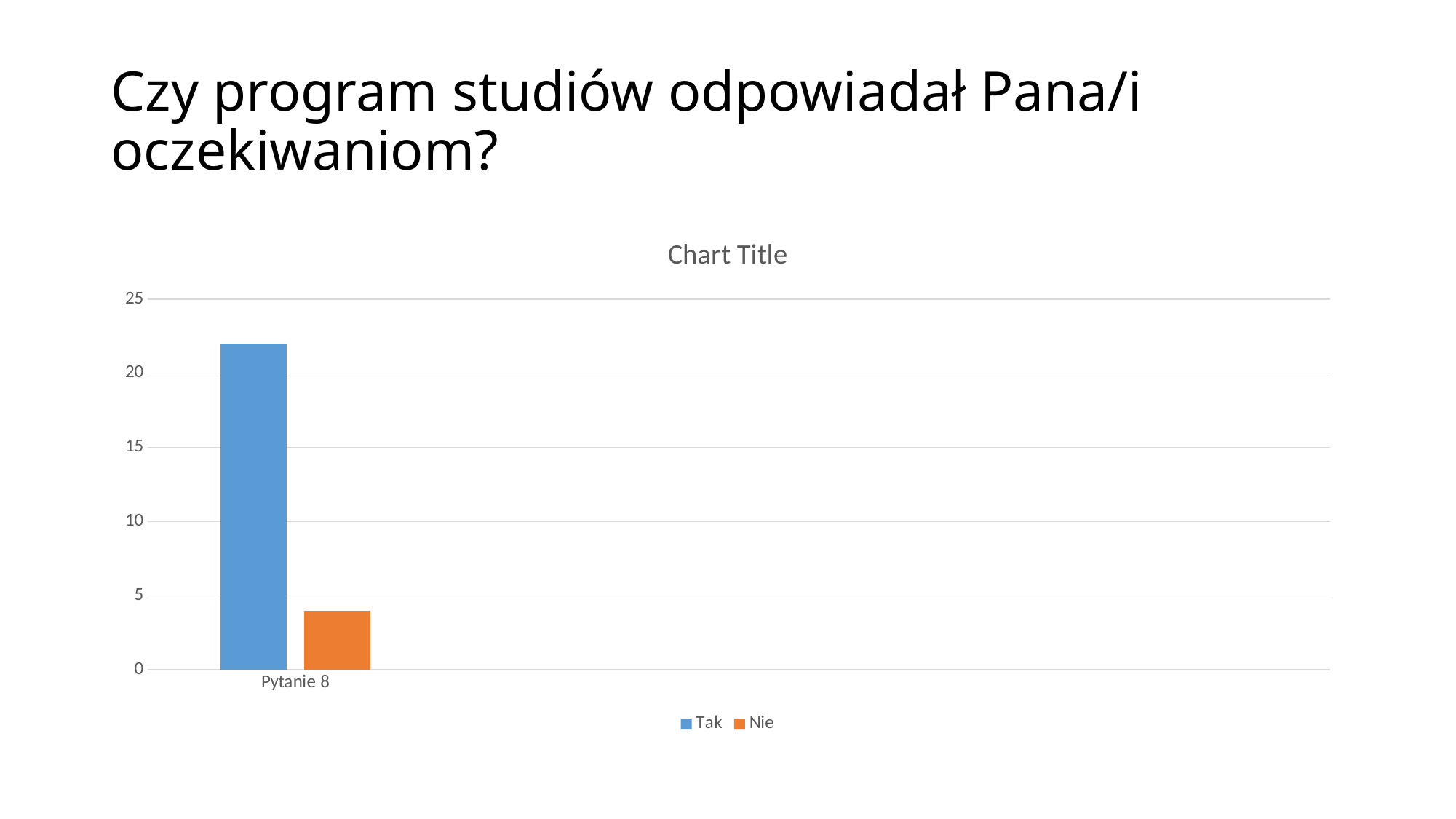
Which series has the higher value for Pytanie 8, Tak or Nie? Tak Which series has the lowest value for Pytanie 8? Nie How many categories are shown on the x axis? 1 Is the value for Tak greater or less than 25? less What kind of chart is shown on the slide? bar chart What colour is the bar for the Nie series? orange Is the value for Nie greater or less than 10? less Is the value for Tak greater or less than 20? greater What is the title shown above the chart? Chart Title How many series does the legend list? 2 Which series has the highest value for Pytanie 8? Tak